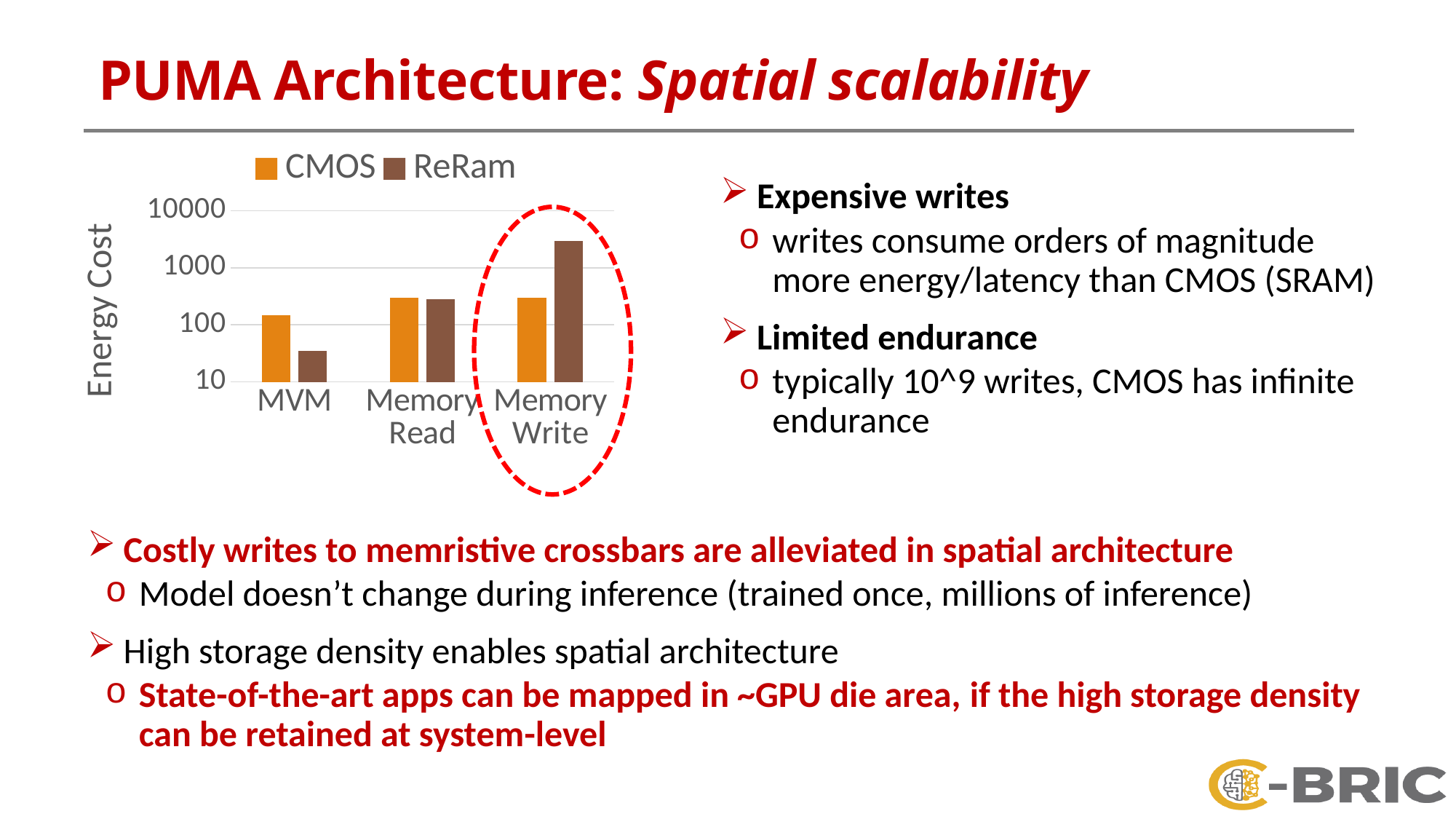
How many categories are shown on the x axis of the chart? 3 How many series does the chart legend list? 2 For MVM, which series has the larger energy cost, CMOS or ReRam? CMOS What is the label on the y axis of the chart? Energy Cost Is the CMOS value for MVM greater or less than 100? greater Which category on the chart is highlighted with a red dashed ellipse? Memory Write Is the ReRam value for MVM greater or less than 100? less Which category has the highest ReRam energy cost? Memory Write Is the ReRam value for Memory Write greater or less than 1000? greater What kind of chart is shown on the slide? Bar chart Which category has the lowest ReRam energy cost? MVM For Memory Write, which series has the larger energy cost, CMOS or ReRam? ReRam